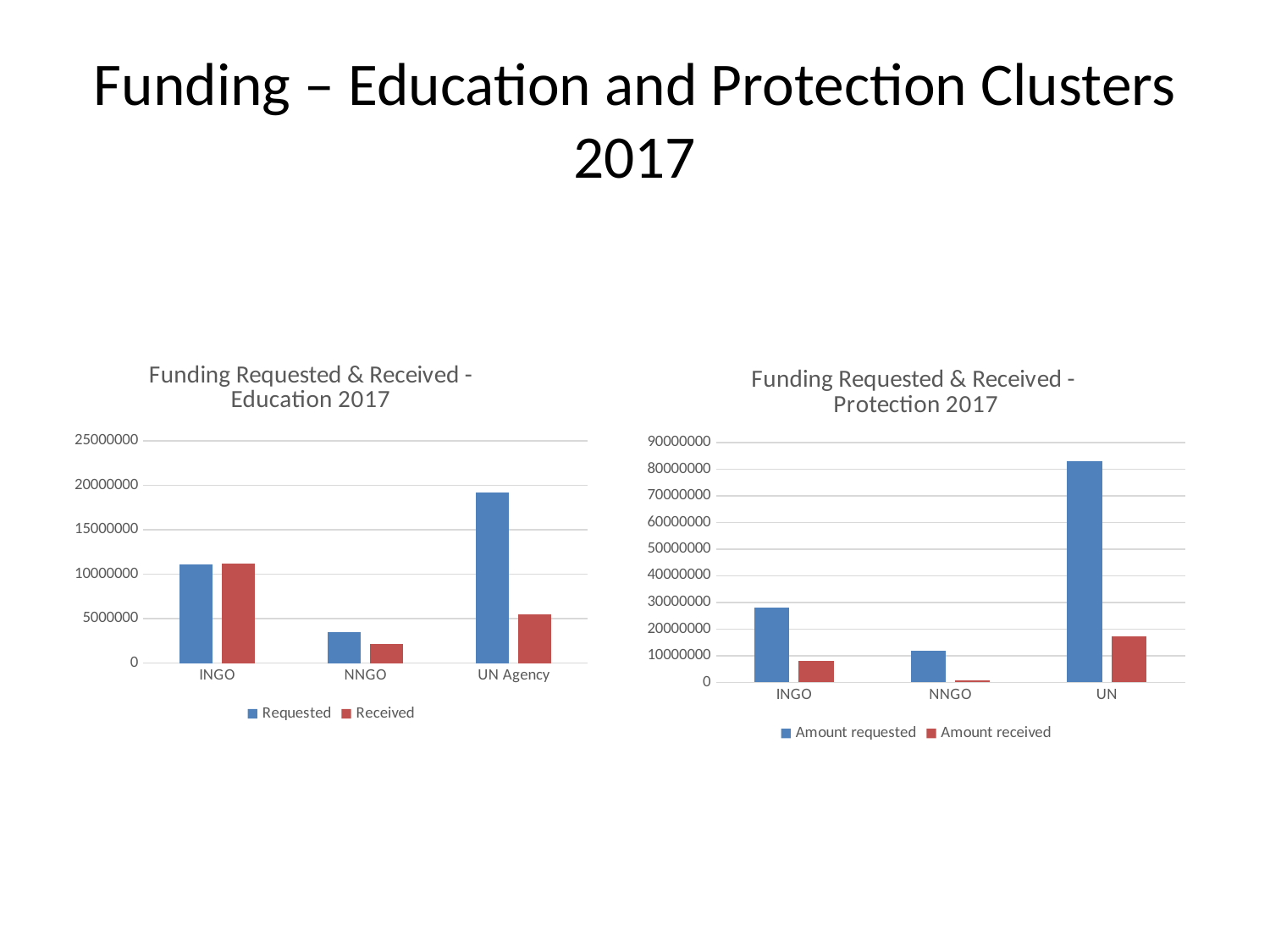
In the 'Funding Requested & Received - Education 2017' chart, how many categories are shown on the x axis? 3 In the 'Funding Requested & Received - Protection 2017' chart, is the Amount requested for UN greater or less than 80000000? greater What kind of chart is the 'Funding Requested & Received - Education 2017' chart? bar chart In the 'Funding Requested & Received - Protection 2017' chart, which category has the highest Amount requested? UN In the 'Funding Requested & Received - Education 2017' chart, is the Received value for UN Agency greater or less than 10000000? less In the 'Funding Requested & Received - Education 2017' chart, is the Requested value for UN Agency greater or less than 15000000? greater In the 'Funding Requested & Received - Education 2017' chart, how many series does the legend list? 2 In the 'Funding Requested & Received - Education 2017' chart, which category has the highest Requested value? UN Agency In the 'Funding Requested & Received - Education 2017' chart, which category has the lowest Received value? NNGO What are the two legend entries in the 'Funding Requested & Received - Protection 2017' chart? Amount requested, Amount received In the 'Funding Requested & Received - Protection 2017' chart, which is larger for INGO: Amount requested or Amount received? Amount requested